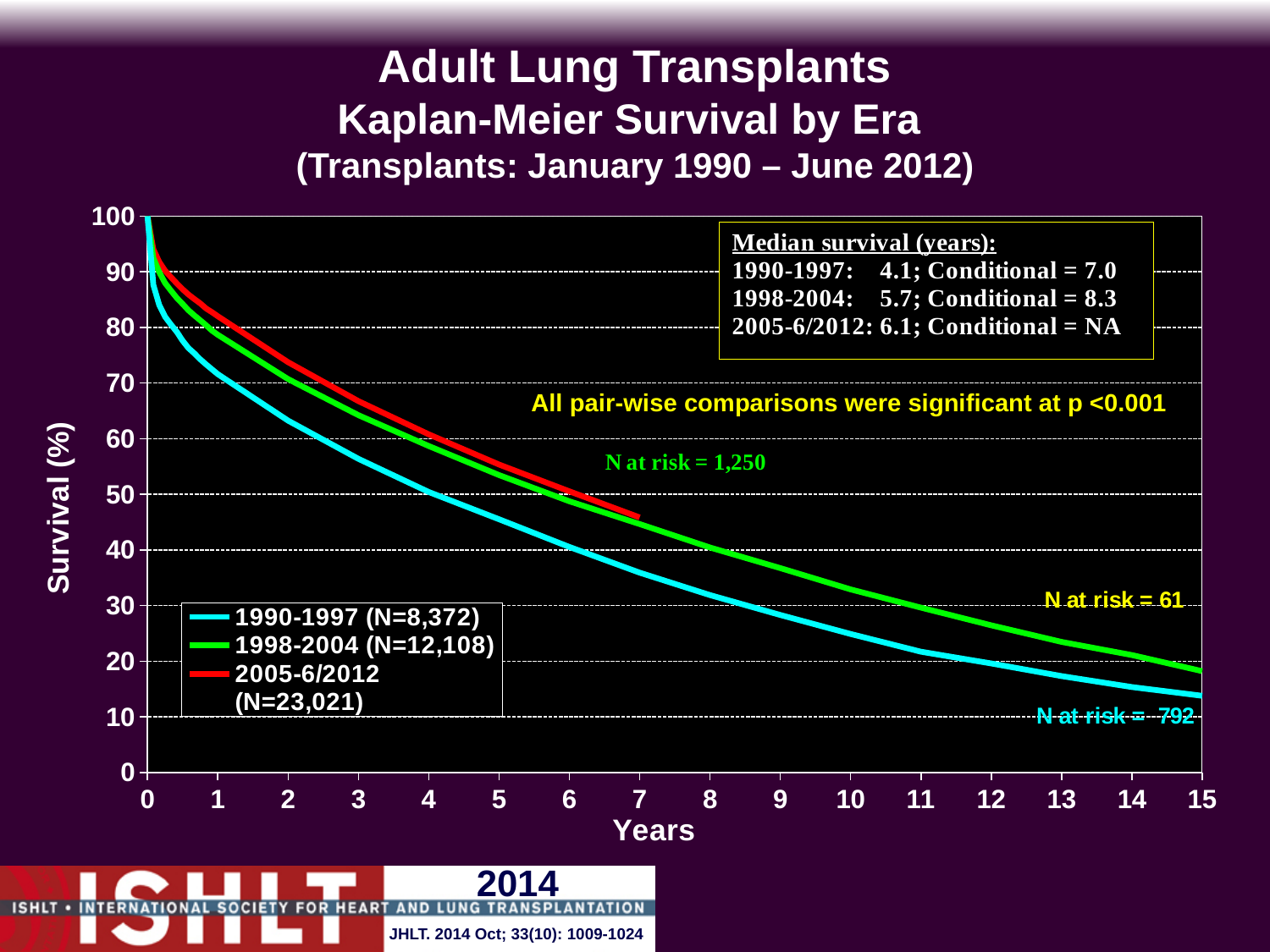
Do the survival curves rise or fall as years increase? fall What is the N shown in the legend for the 2005-6/2012 era? 23,021 How many series does the legend list? 3 What kind of chart is shown on the slide? line chart At 10 years, which era has higher survival: 1990-1997 or 1998-2004? 1998-2004 What is the label of the y axis? Survival (%) Is the survival value for the 1998-2004 era at 15 years greater or less than 20? less Is the survival value for the 1990-1997 era at 10 years greater or less than 20? greater Is the survival value for the 1998-2004 era at 5 years greater or less than 50? greater At 5 years, which era has higher survival: 1990-1997 or 1998-2004? 1998-2004